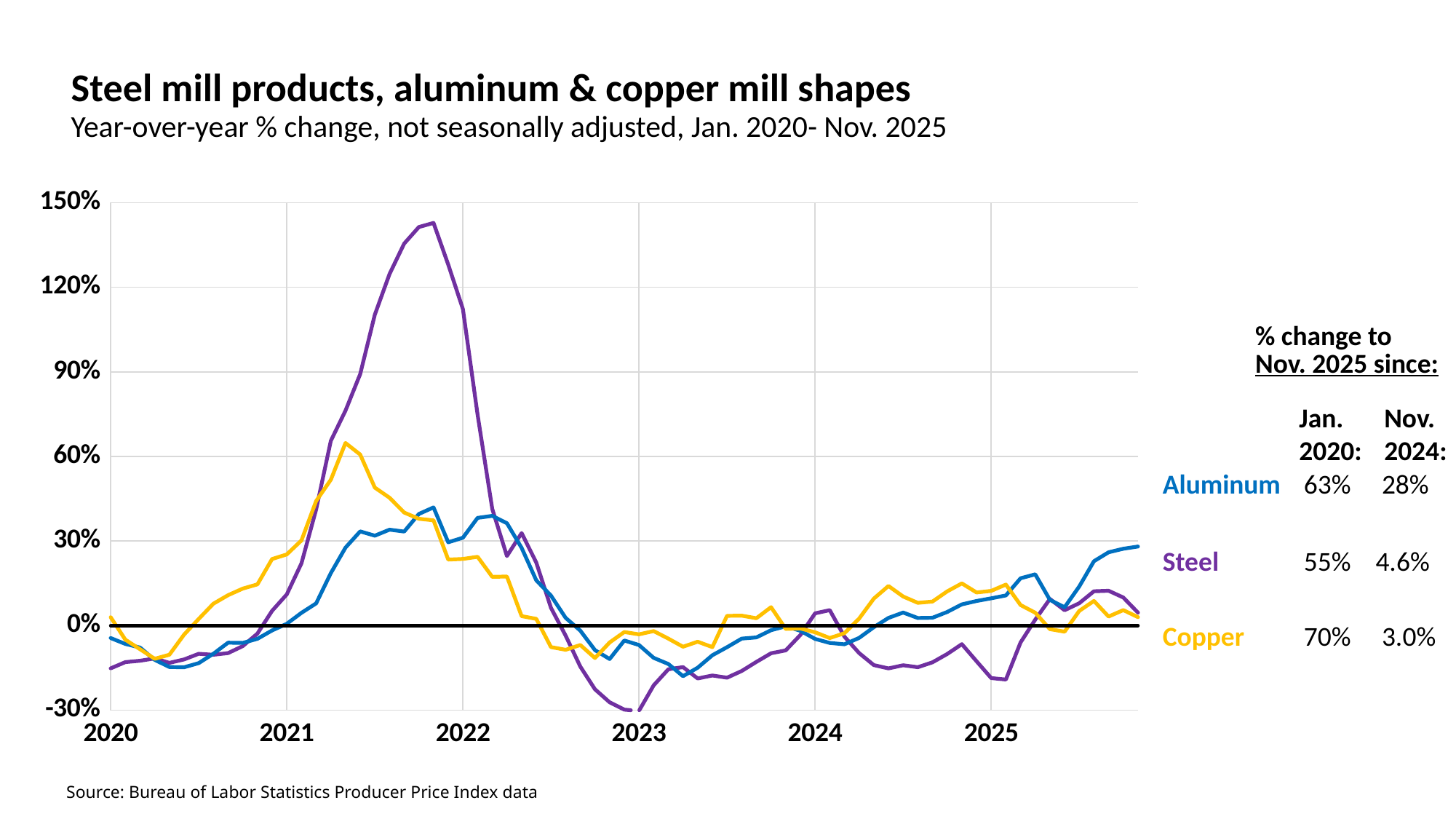
Is the peak value of the Steel line greater or less than 120%? greater How many series are plotted on the chart? 3 What is the title of the chart? Steel mill products, aluminum & copper mill shapes Is the lowest value of the Steel line, around early 2023, greater or less than -20%? less According to the side table, what is the % change in Steel to Nov. 2025 since Nov. 2024? 4.6% Is the peak value of the Aluminum line in late 2021 greater or less than 30%? greater Which series reaches the highest year-over-year % change on the chart? Steel According to the side table, what is the % change in Copper to Nov. 2025 since Jan. 2020? 70% What kind of chart is shown on the slide? Line chart According to the side table, what is the % change in Aluminum to Nov. 2025 since Jan. 2020? 63% How many percentage points higher is Copper's % change since Jan. 2020 than Aluminum's, per the side table? 7 percentage points Which has the larger % change to Nov. 2025 since Jan. 2020, Aluminum or Copper? Copper